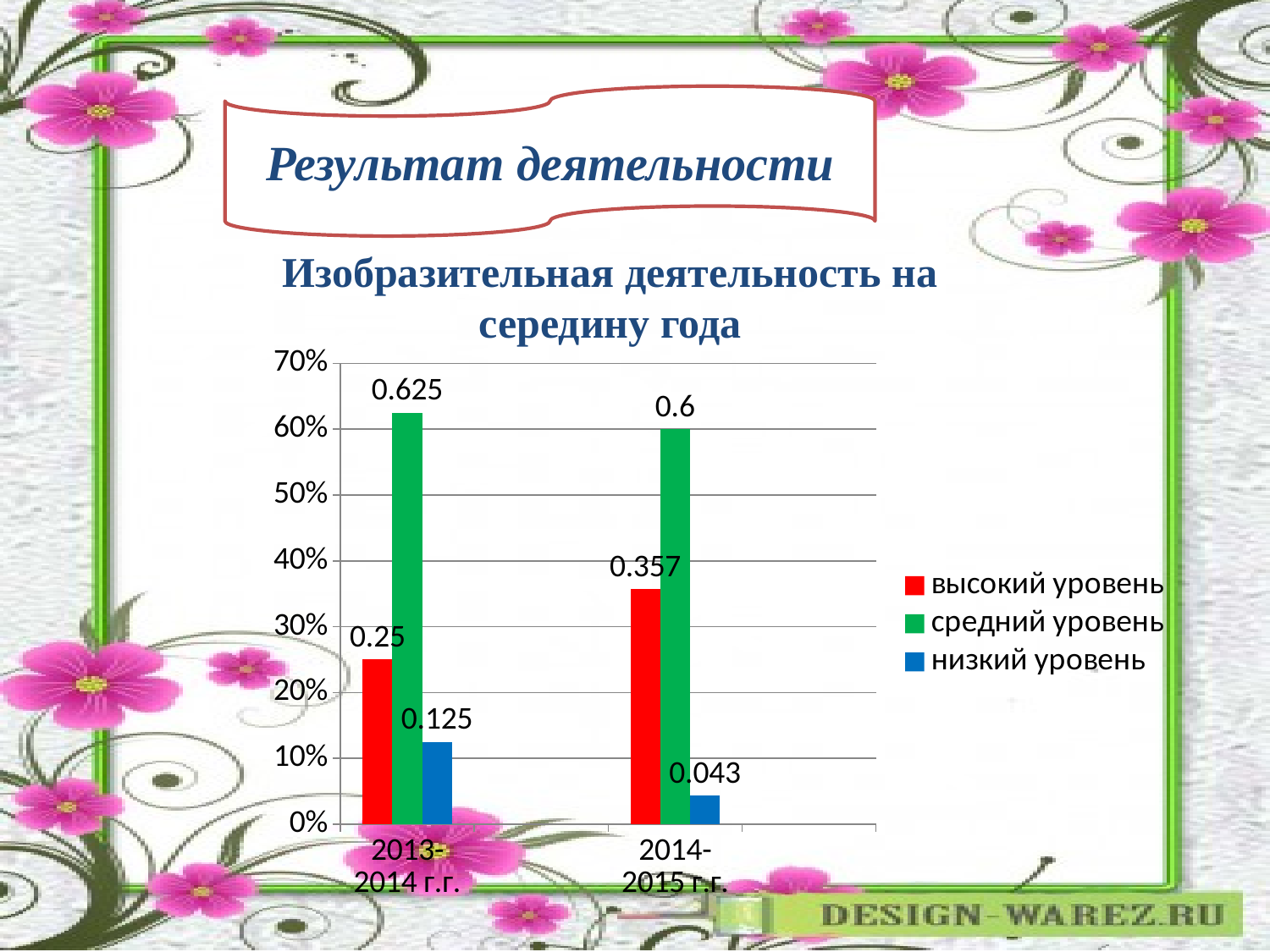
How many series does the legend list? 3 Is the value for средний уровень in 2014-2015 г.г. greater or less than 50%? greater What is the value for средний уровень in 2013-2014 г.г.? 0.625 What is the value for низкий уровень in 2013-2014 г.г.? 0.125 What is the difference between the высокий уровень values for 2014-2015 г.г. and 2013-2014 г.г.? 0.107 Which series has the lowest value in 2013-2014 г.г.? низкий уровень Which series has the highest value in 2014-2015 г.г.? средний уровень What is the value for высокий уровень in 2014-2015 г.г.? 0.357 Which is larger: высокий уровень in 2013-2014 г.г. or высокий уровень in 2014-2015 г.г.? 2014-2015 г.г. What kind of chart is shown on the slide? bar chart What colour represents низкий уровень in the legend? blue What is the value for низкий уровень in 2014-2015 г.г.? 0.043